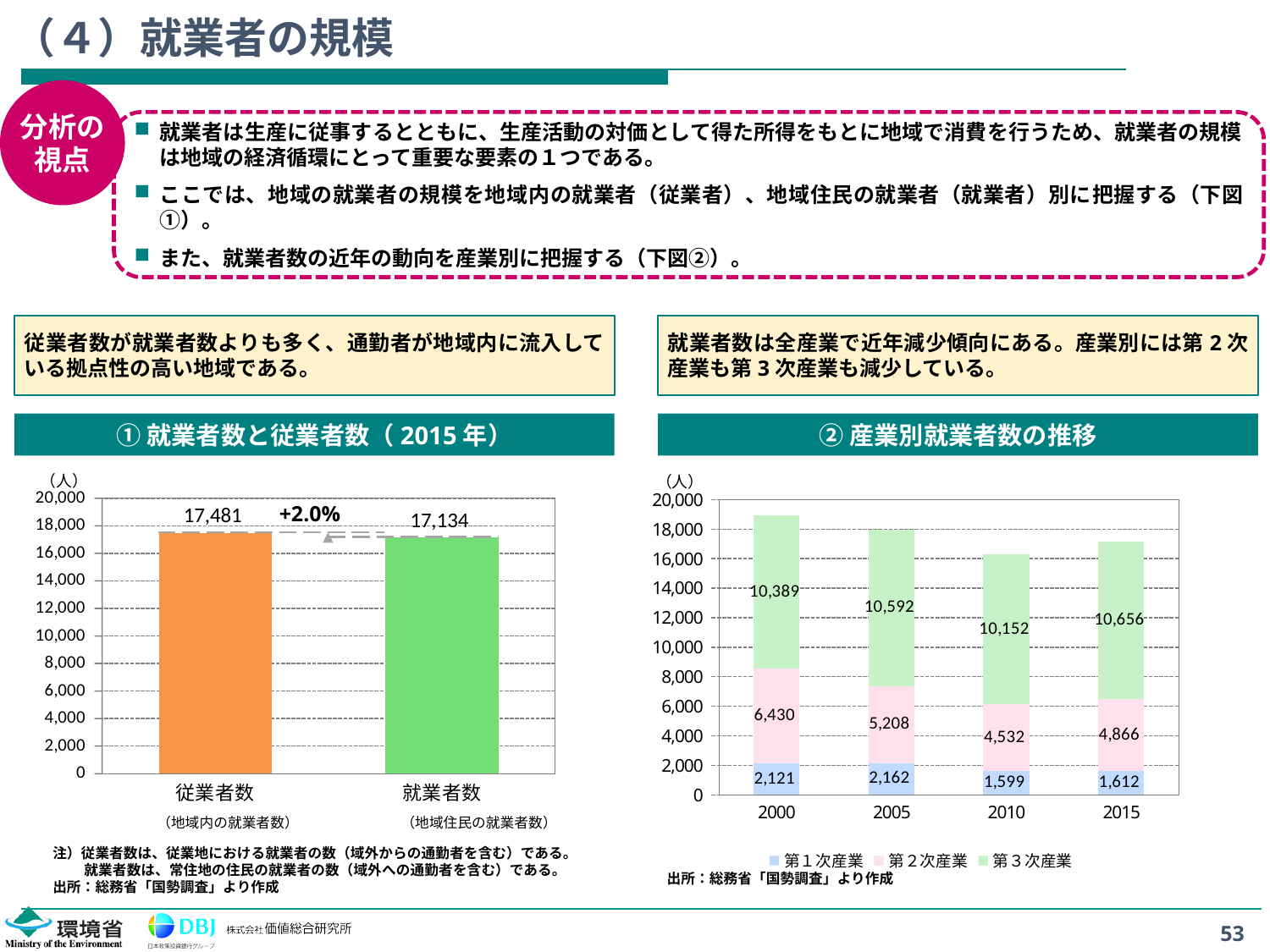
In the chart ② 産業別就業者数の推移, what is the total of the stacked bar for 2000? 18,940 In the chart ① 就業者数と従業者数（2015年）, what is the difference between 従業者数 and 就業者数? 347 In the chart ① 就業者数と従業者数（2015年）, what is the value for 従業者数? 17,481 In the chart ② 産業別就業者数の推移, how many series does the legend list? 3 In the chart ② 産業別就業者数の推移, what is the value for 第1次産業 in 2010? 1,599 In the chart ① 就業者数と従業者数（2015年）, which is larger, 従業者数 or 就業者数? 従業者数 In the chart ① 就業者数と従業者数（2015年）, what is the value for 就業者数? 17,134 In the chart ② 産業別就業者数の推移, which year has the highest value for 第2次産業? 2000 What kind of chart is ① 就業者数と従業者数（2015年）? bar chart In the chart ② 産業別就業者数の推移, what is the value for 第3次産業 in 2015? 10,656 In the chart ② 産業別就業者数の推移, what is the value for 第2次産業 in 2005? 5,208 In the chart ② 産業別就業者数の推移, how many years are shown on the x axis? 4